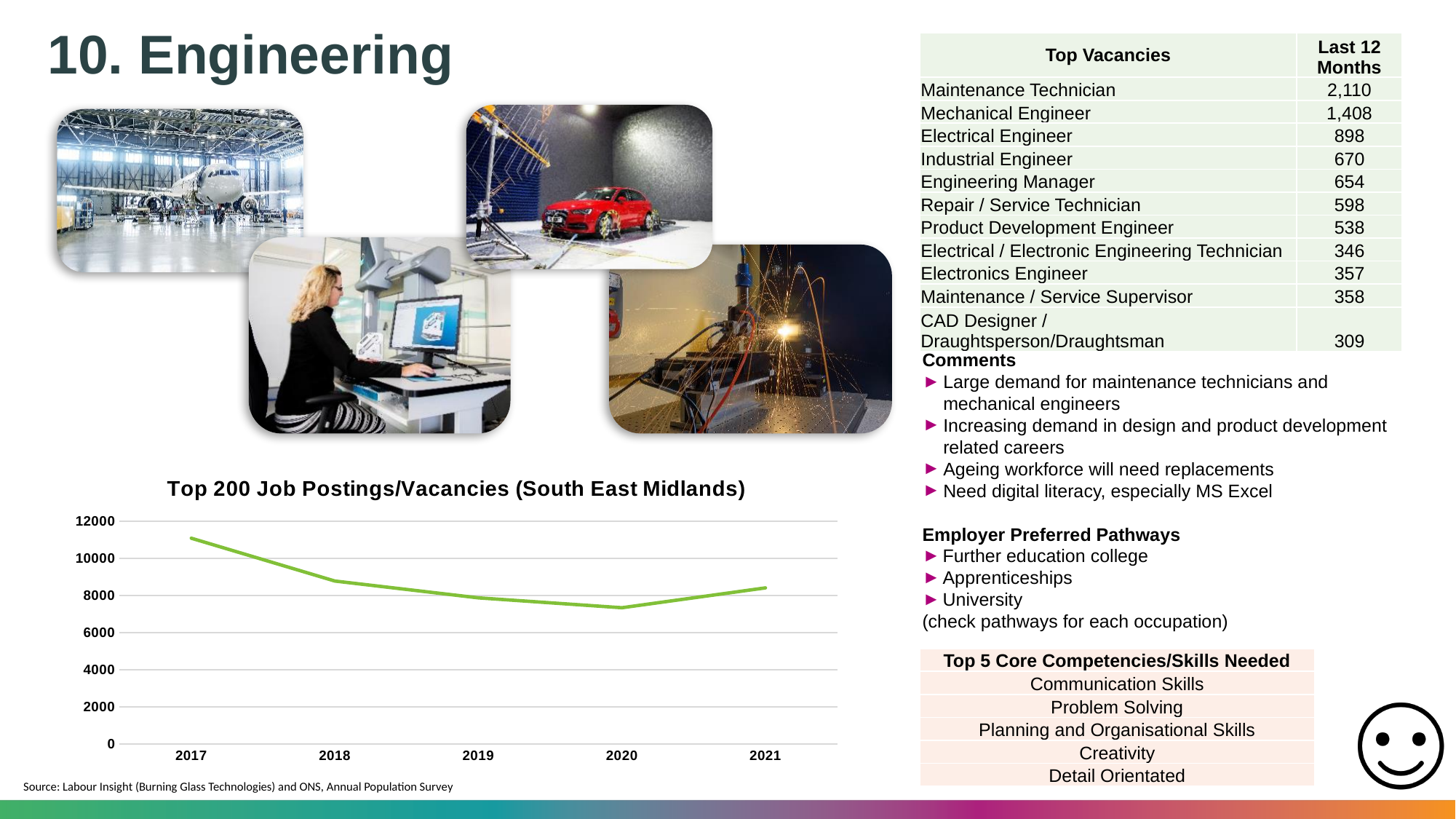
How many years are plotted on the x axis of the chart? 5 Is the value for 2020 greater or less than 8000? less Do the values rise or fall from 2017 to 2020? fall Is the value for 2018 greater or less than 10000? less Which year has the lowest value in the chart? 2020 Which is larger, the value for 2017 or the value for 2021? 2017 Is the value for 2017 greater or less than 10000? greater Which year has the highest value in the chart? 2017 What is the title of the chart? Top 200 Job Postings/Vacancies (South East Midlands) What kind of chart is shown on the slide? line chart Do the values rise or fall from 2020 to 2021? rise